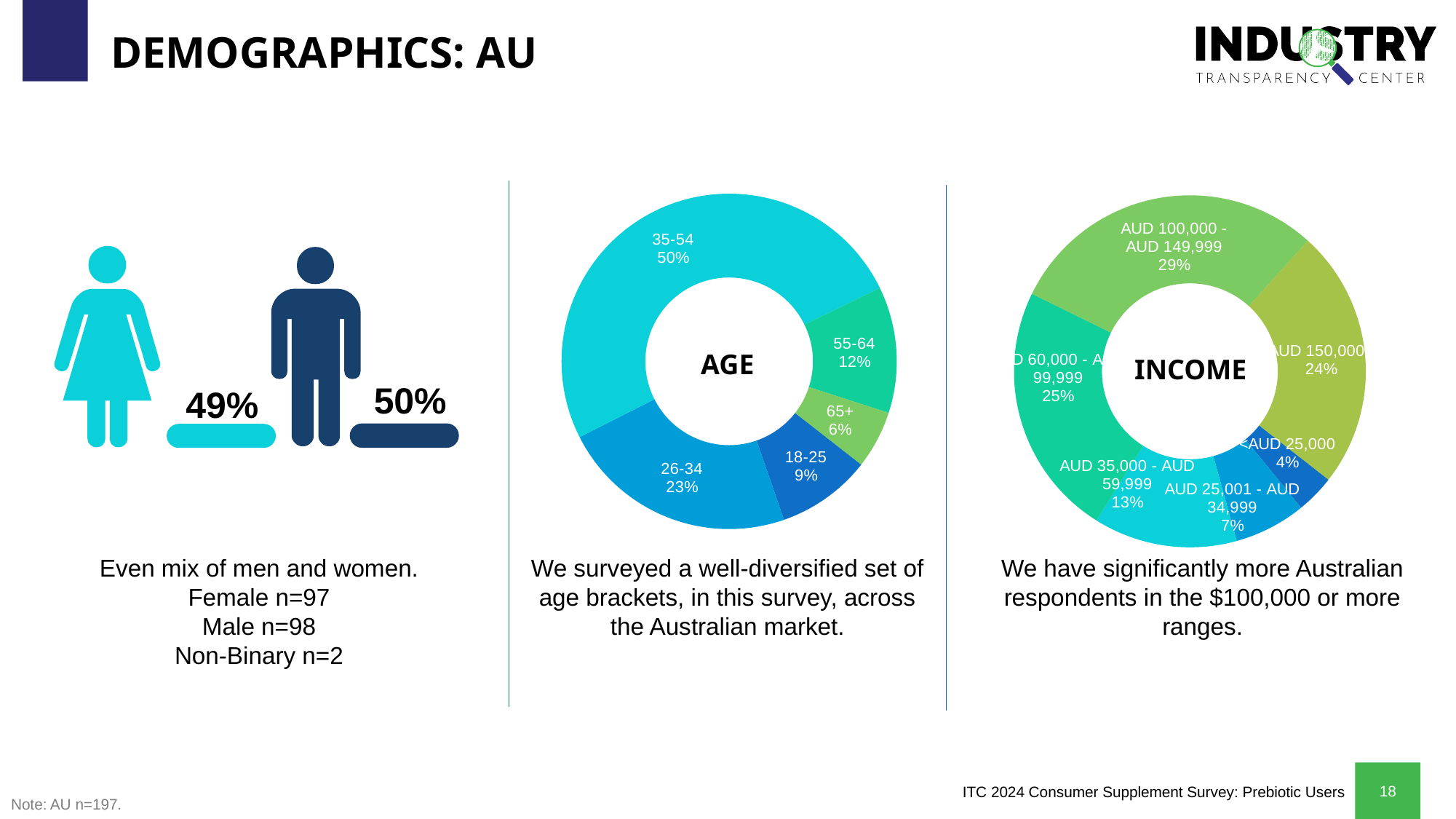
On the AGE chart, what percentage of respondents are aged 55-64? 12% On the INCOME chart, which income range has the smallest share? <AUD 25,000 How many age brackets are shown on the AGE chart? 5 On the AGE chart, which age bracket has the largest share? 35-54 How many income ranges are shown on the INCOME chart? 6 On the AGE chart, what percentage of respondents are aged 35-54? 50% On the INCOME chart, what is the difference in percentage points between the AUD 100,000 - AUD 149,999 range and the AUD 150,000 range? 5 percentage points What kind of chart is the AGE chart? Donut (pie) chart On the INCOME chart, what percentage of respondents earn AUD 100,000 - AUD 149,999? 29% On the INCOME chart, which is larger: the share for AUD 35,000 - AUD 59,999 or the share for AUD 25,001 - AUD 34,999? AUD 35,000 - AUD 59,999 On the AGE chart, which age bracket has the smallest share? 65+ On the AGE chart, what is the difference in percentage points between the 26-34 and 18-25 brackets? 14 percentage points